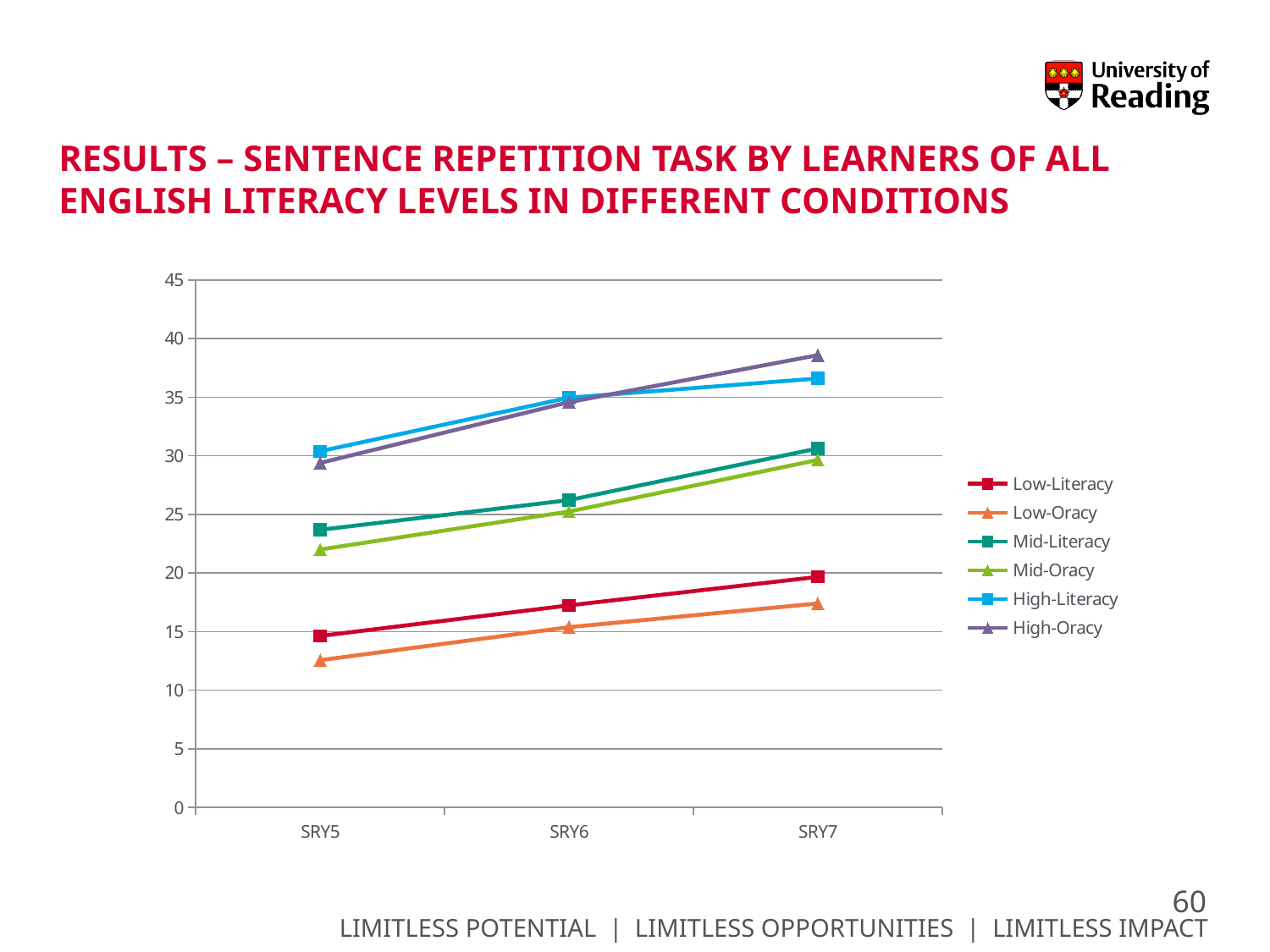
At SRY7, which is larger: High-Oracy or High-Literacy? High-Oracy Does the Low-Literacy line rise or fall from SRY5 to SRY7? rise At SRY6, which is larger: Mid-Literacy or Low-Literacy? Mid-Literacy How many categories are shown on the x axis? 3 What kind of chart is shown on the slide? line chart Is the value for High-Oracy at SRY7 greater or less than 35? greater Which series has the lowest value at SRY7? Low-Oracy Is the value for Mid-Oracy at SRY5 greater or less than 20? greater How many series does the legend list? 6 Is the value for Low-Oracy at SRY5 greater or less than 15? less What are the three categories on the x axis? SRY5, SRY6, SRY7 Which series has the highest value at SRY7? High-Oracy